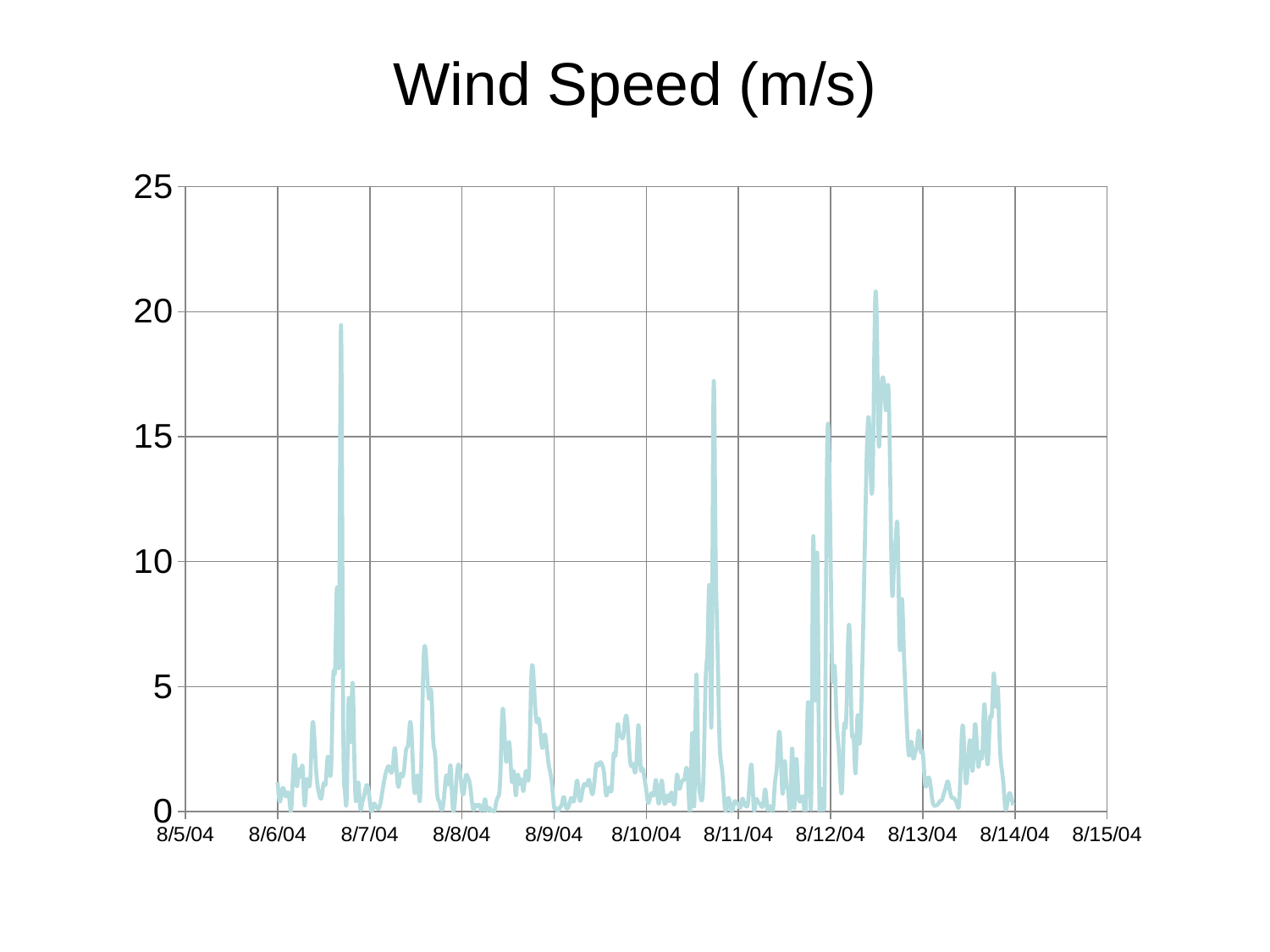
How many date labels are shown on the x axis? 11 What is the title of the chart? Wind Speed (m/s) Between which two dates on the x axis does the highest wind speed peak occur? 8/12/04 and 8/13/04 Is the peak wind speed that occurs between 8/6/04 and 8/7/04 greater or less than 15? greater Is the highest peak of the wind speed line greater or less than 20? greater Is the peak wind speed that occurs between 8/6/04 and 8/7/04 greater or less than 20? less Which is higher: the peak between 8/12/04 and 8/13/04 or the peak just before 8/11/04? the peak between 8/12/04 and 8/13/04 What is the maximum value shown on the y axis? 25 On which date label does the plotted wind speed line begin? 8/6/04 What kind of chart is shown on the slide? line chart